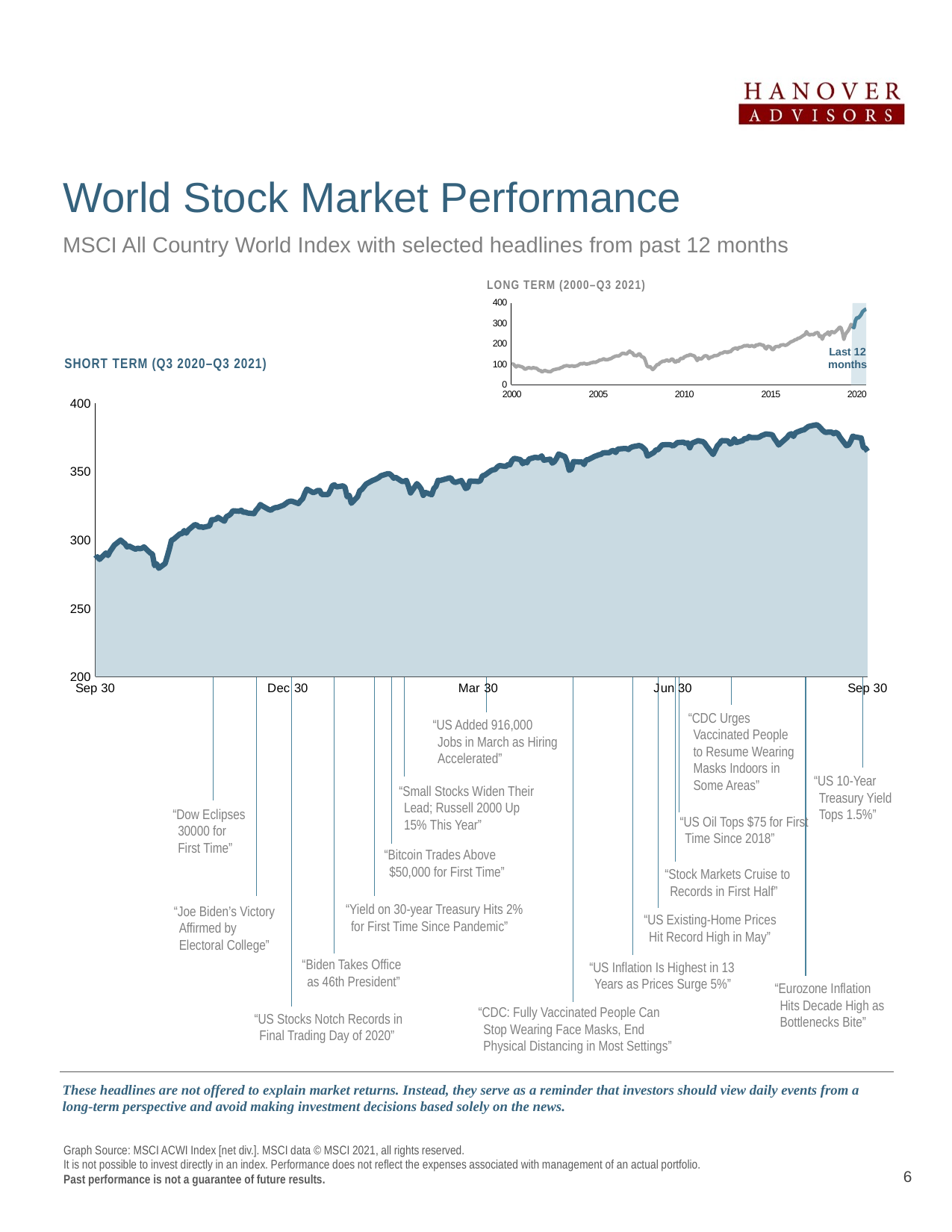
On the SHORT TERM (Q3 2020–Q3 2021) chart, is the index value at Mar 30 greater or less than 300? greater On the LONG TERM (2000–Q3 2021) chart, does the index generally rise or fall from 2000 to 2020? Rise What is the title of the smaller chart in the upper right of the slide? LONG TERM (2000–Q3 2021) On the SHORT TERM (Q3 2020–Q3 2021) chart, does the index generally rise or fall from Sep 30 to Sep 30? Rise On the LONG TERM (2000–Q3 2021) chart, is the index value in 2020 greater or less than 200? greater On the SHORT TERM (Q3 2020–Q3 2021) chart, which is larger: the index value at the first Sep 30 or at the final Sep 30? The final Sep 30 On the SHORT TERM (Q3 2020–Q3 2021) chart, what kind of chart is used to show the index? Line chart (area chart) On the SHORT TERM (Q3 2020–Q3 2021) chart, is the index value at the final Sep 30 greater or less than 350? greater On the LONG TERM (2000–Q3 2021) chart, what label is given to the shaded region at the right end? Last 12 months How many date labels are shown on the x axis of the SHORT TERM (Q3 2020–Q3 2021) chart? 5 On the LONG TERM (2000–Q3 2021) chart, which is larger: the index value in 2000 or in 2020? 2020